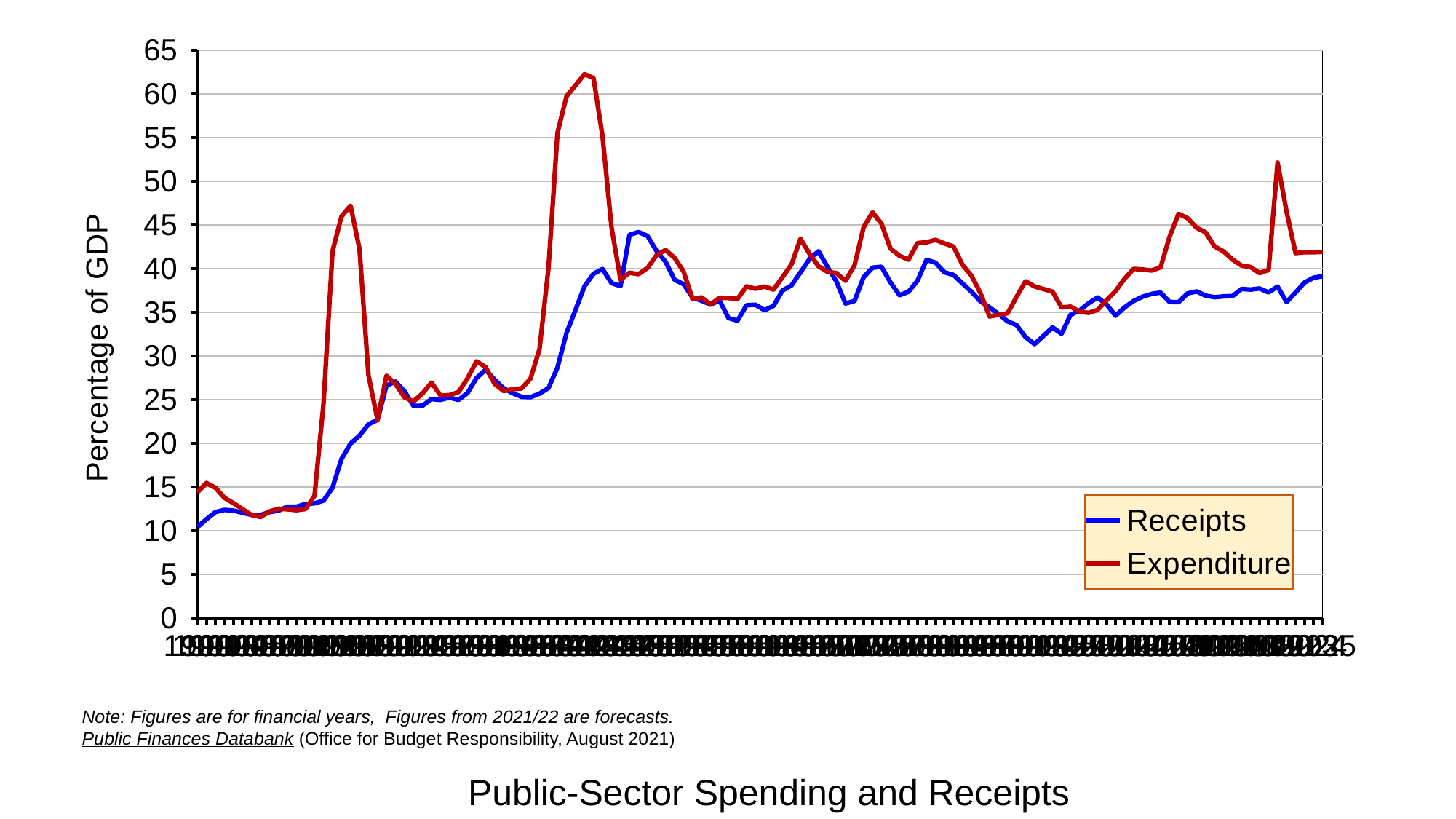
Is the highest value reached by the Expenditure series greater or less than 60? greater Overall, do the values of both series rise or fall from the left of the x axis to the right? rise How many series does the legend list? 2 What are the two series named in the legend? Receipts and Expenditure What is the title of the y axis? Percentage of GDP Is the lowest value of the Receipts series greater or less than 15? less Is the highest value reached by the Receipts series greater or less than 50? less What kind of chart is shown on the slide? Line chart At the far right end of the chart, which series is higher, Receipts or Expenditure? Expenditure Which series reaches the highest value on the chart? Expenditure